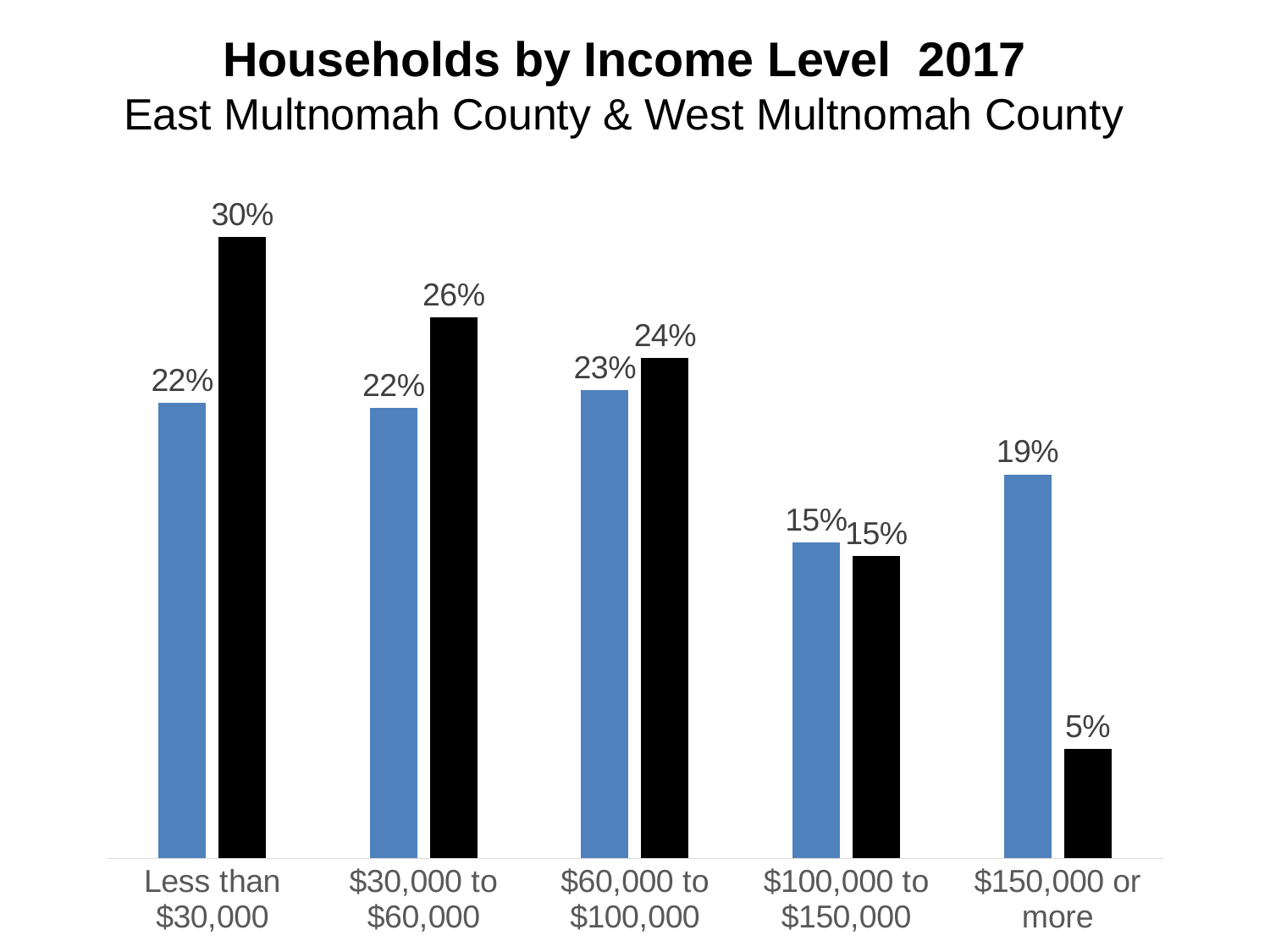
What is the difference between the blue and black bars for the '$150,000 or more' category? 14% Which income category has the lowest blue bar? $100,000 to $150,000 What is the value of the blue bar for the '$150,000 or more' category? 19% What is the value of the black bar for the 'Less than $30,000' category? 30% Which income category has the lowest black bar? $150,000 or more What is the value of the black bar for the '$30,000 to $60,000' category? 26% What type of chart is shown on the slide? bar chart For the 'Less than $30,000' category, which bar is larger, the blue or the black? black What is the value of the blue bar for the '$60,000 to $100,000' category? 23% How many income level categories are shown on the x axis? 5 Which income category has the highest black bar? Less than $30,000 What is the title of the chart? Households by Income Level 2017